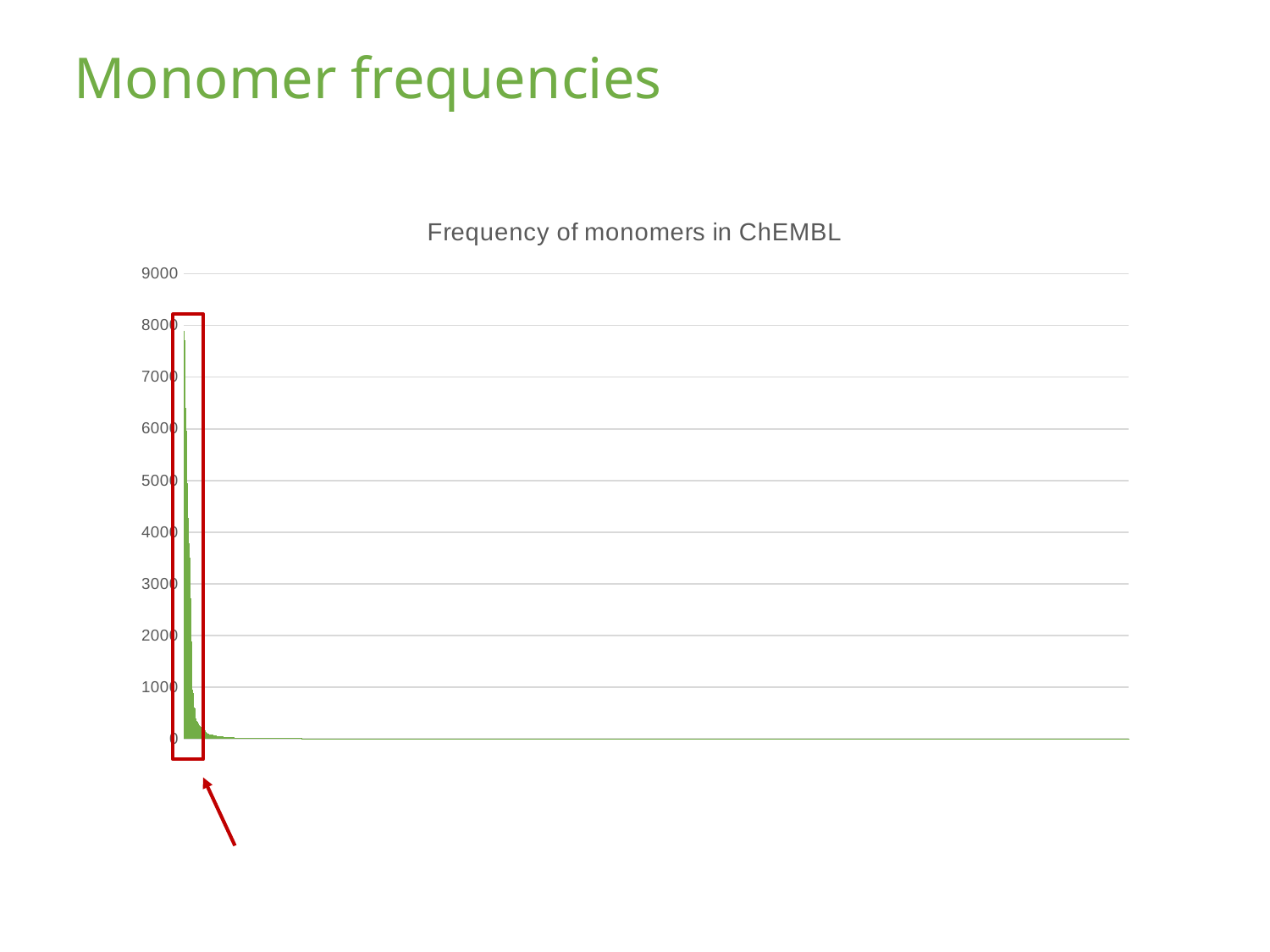
Are the values at the right-hand end of the chart greater or less than 1000? less Is the highest value plotted in the chart greater or less than 9000? less What is the highest value shown on the y axis of the chart? 9000 What is the title of the chart on the slide? Frequency of monomers in ChEMBL Do the values in the chart rise or fall moving from left to right along the x axis? fall Is the highest value plotted in the chart greater or less than 7000? greater